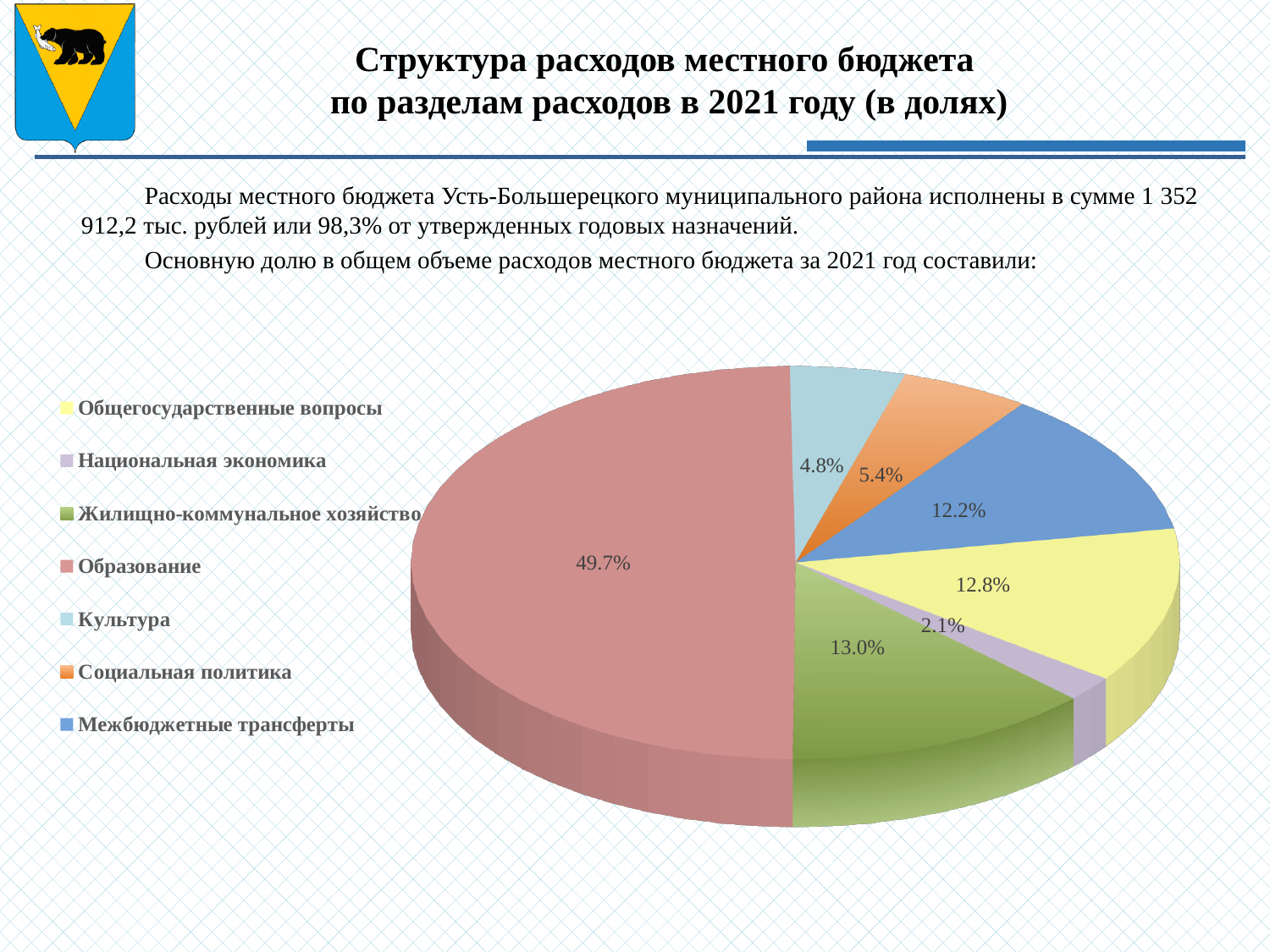
What colour is the slice for Образование? pink Which category has the largest share of the pie? Образование Which category has the smallest share of the pie? Национальная экономика How many slices does the pie chart have? 7 What is the difference between the shares of Общегосударственные вопросы and Социальная политика? 7.4% What share of the pie does Образование have? 49.7% How many entries does the legend list? 7 Which is larger: the share of Социальная политика or the share of Культура? Социальная политика What is the value shown for Межбюджетные трансферты? 12.2% What is the value shown for Жилищно-коммунальное хозяйство? 13.0% What is the value shown for Культура? 4.8% What kind of chart is shown on the slide? pie chart